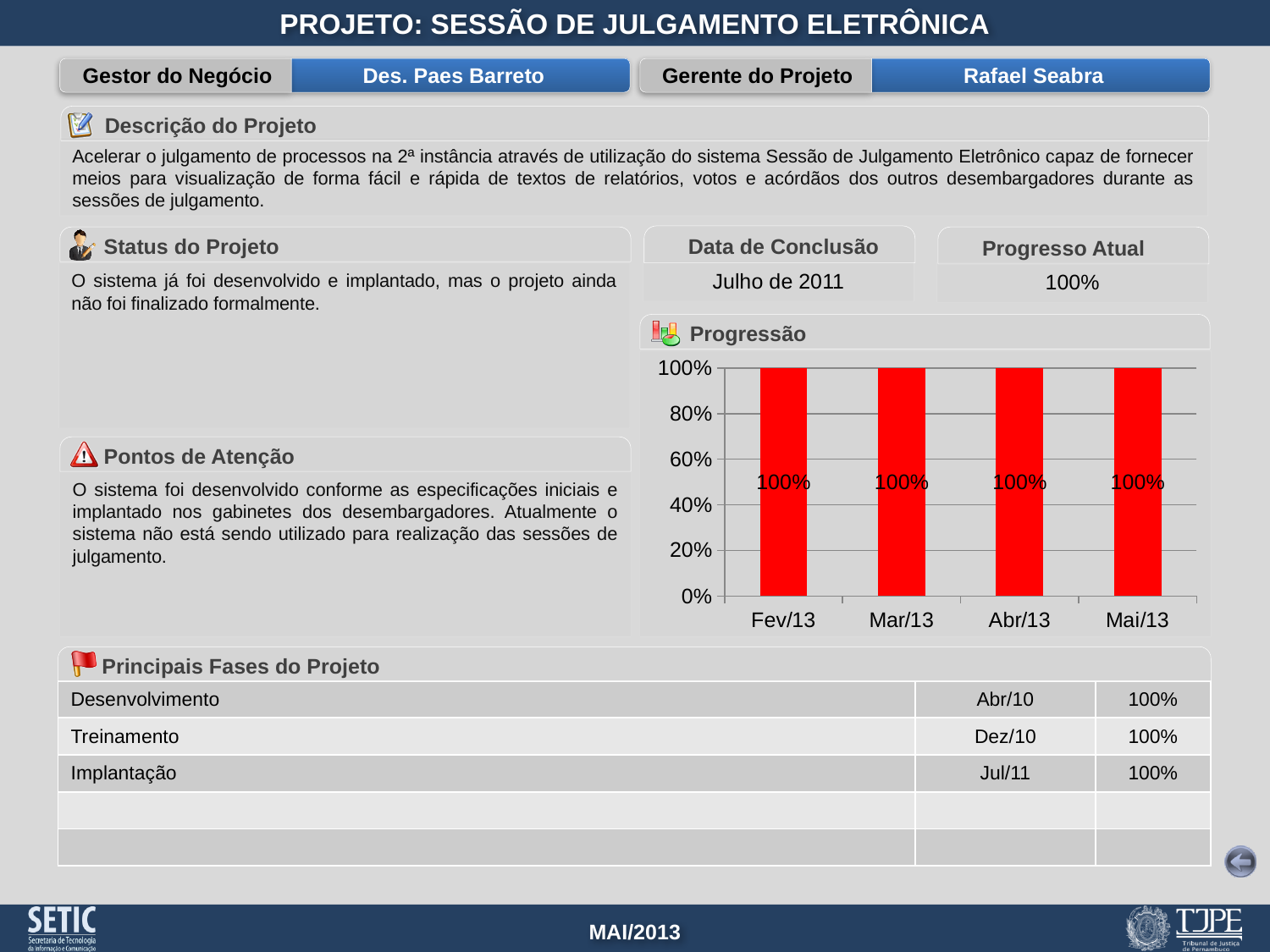
What is the title of the chart on the slide? Progressão What kind of chart is the Progressão chart? bar chart How many categories are shown on the x axis of the Progressão chart? 4 Is the value for Fev/13 larger than, smaller than, or equal to the value for Mar/13 in the Progressão chart? equal What is the value for Abr/13 in the Progressão chart? 100% Do the values in the Progressão chart rise, fall or stay the same from Fev/13 to Mai/13? stay the same Is the value for Abr/13 in the Progressão chart greater or less than 80%? greater What is the value for Mai/13 in the Progressão chart? 100% What is the difference between the values for Mai/13 and Fev/13 in the Progressão chart? 0% What is the value for Fev/13 in the Progressão chart? 100% What colour are the bars in the Progressão chart? red What is the value for Mar/13 in the Progressão chart? 100%